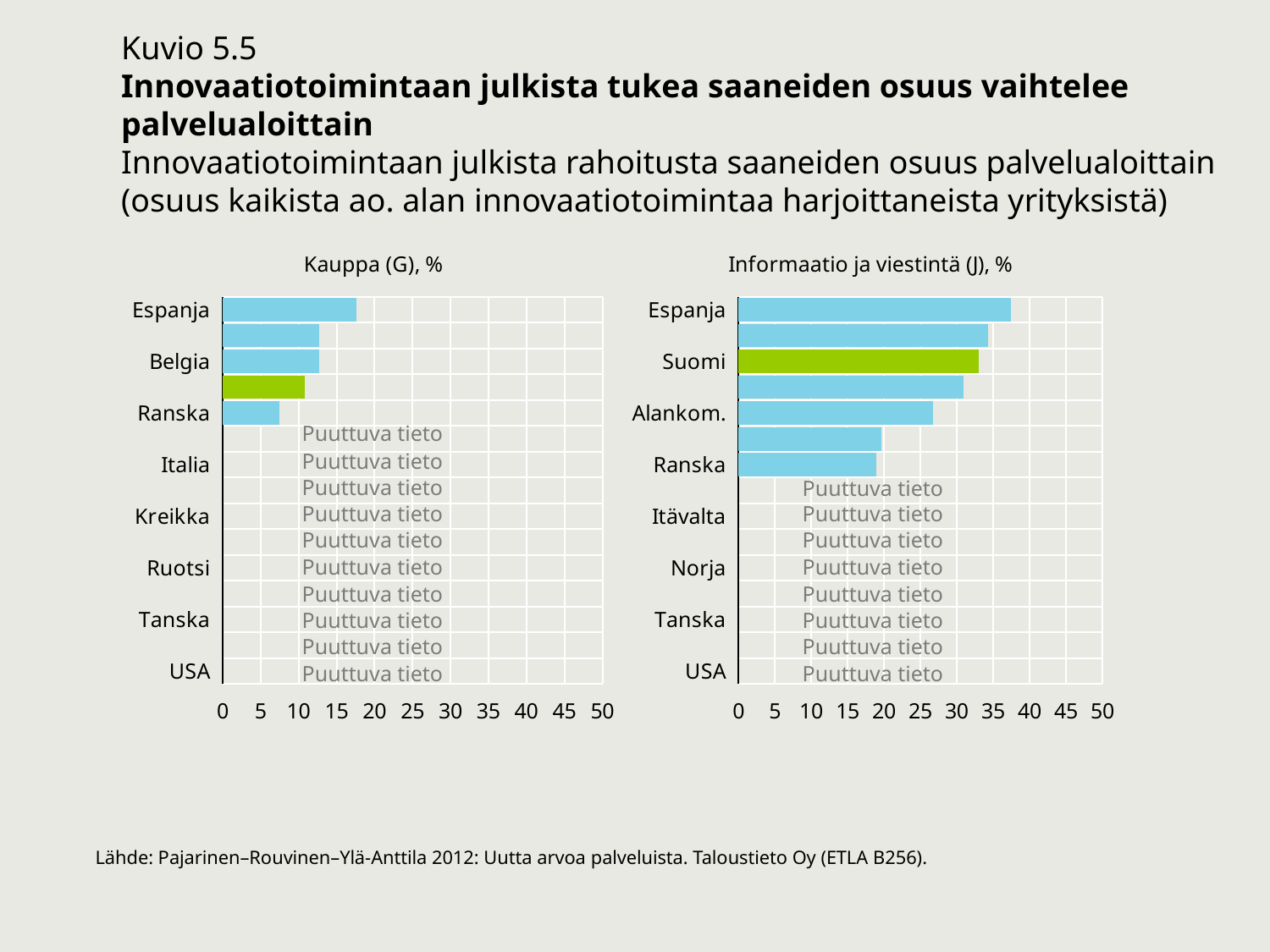
In the 'Kauppa (G), %' chart, is the value for Belgia greater or less than 10? greater In the 'Kauppa (G), %' chart, is the value for Ranska greater or less than 10? less In the 'Informaatio ja viestintä (J), %' chart, which country's bar is coloured green? Suomi What kind of chart is the 'Kauppa (G), %' chart? bar chart In the 'Informaatio ja viestintä (J), %' chart, is the value for Alankom. greater or less than 30? less In the 'Kauppa (G), %' chart, which is larger, the value for Espanja or the value for Ranska? Espanja In the 'Informaatio ja viestintä (J), %' chart, which country has the highest value? Espanja In the 'Kauppa (G), %' chart, how many rows are marked 'Puuttuva tieto'? 10 In the 'Kauppa (G), %' chart, which country has the highest value? Espanja In the 'Informaatio ja viestintä (J), %' chart, which is larger, the value for Suomi or the value for Alankom.? Suomi